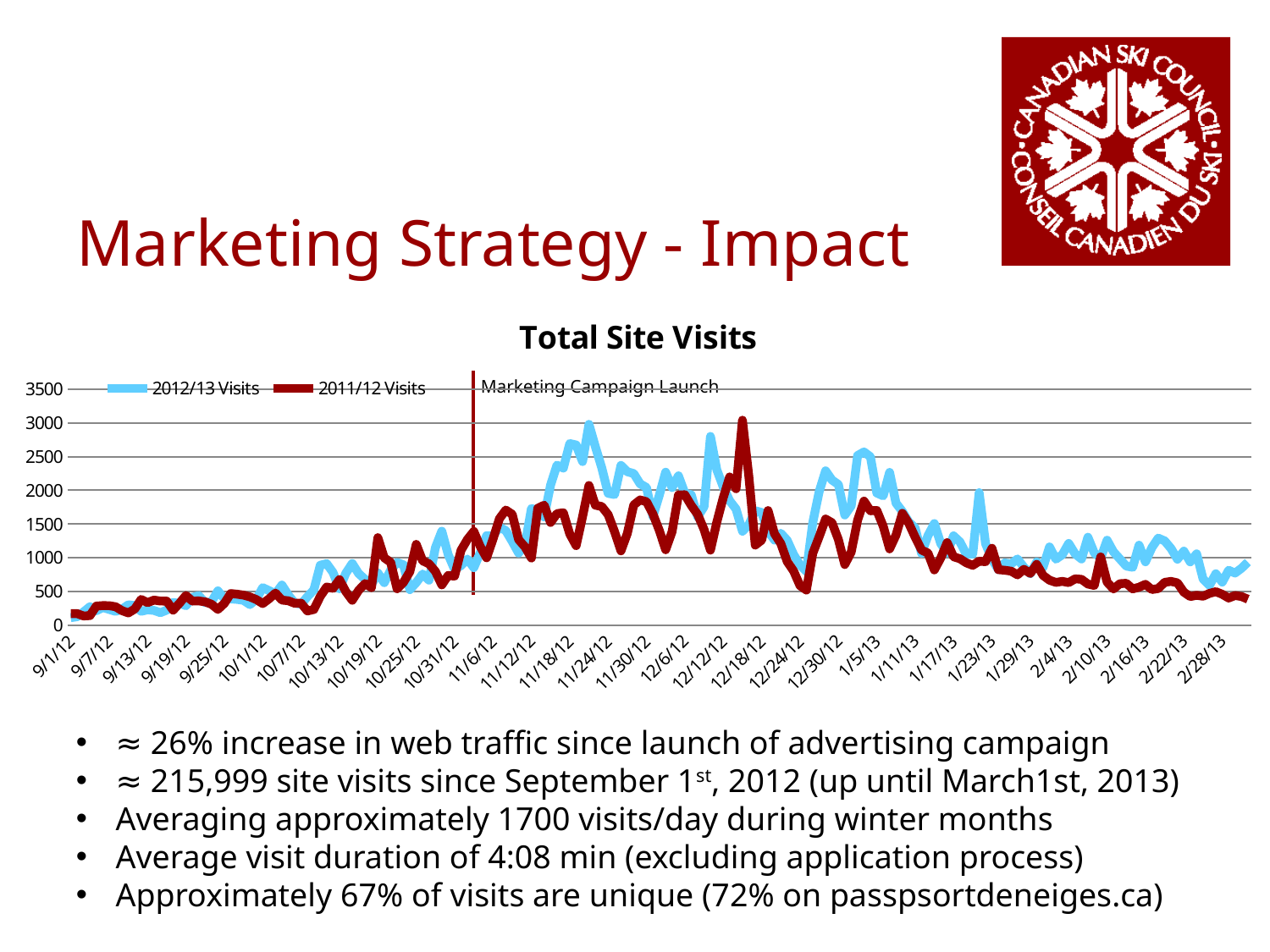
Is the value of the 2012/13 Visits series at 9/1/12 greater or less than 500? less Around 1/5/13, which series has the higher value, 2012/13 Visits or 2011/12 Visits? 2012/13 Visits What kind of chart is shown on the slide? Line chart At 2/28/13, which series has the higher value, 2012/13 Visits or 2011/12 Visits? 2012/13 Visits What is the highest value shown on the vertical axis of the chart? 3500 Do the 2012/13 Visits values generally rise or fall between 9/1/12 and 11/18/12? Rise What is the title of the chart? Total Site Visits Which series is drawn in dark red in the Total Site Visits chart? 2011/12 Visits Is the peak value of the 2012/13 Visits series (around 11/24/12) greater or less than 2500? greater How many series does the legend of the Total Site Visits chart list? 2 Is the value of the 2011/12 Visits series at 2/28/13 greater or less than 1000? less